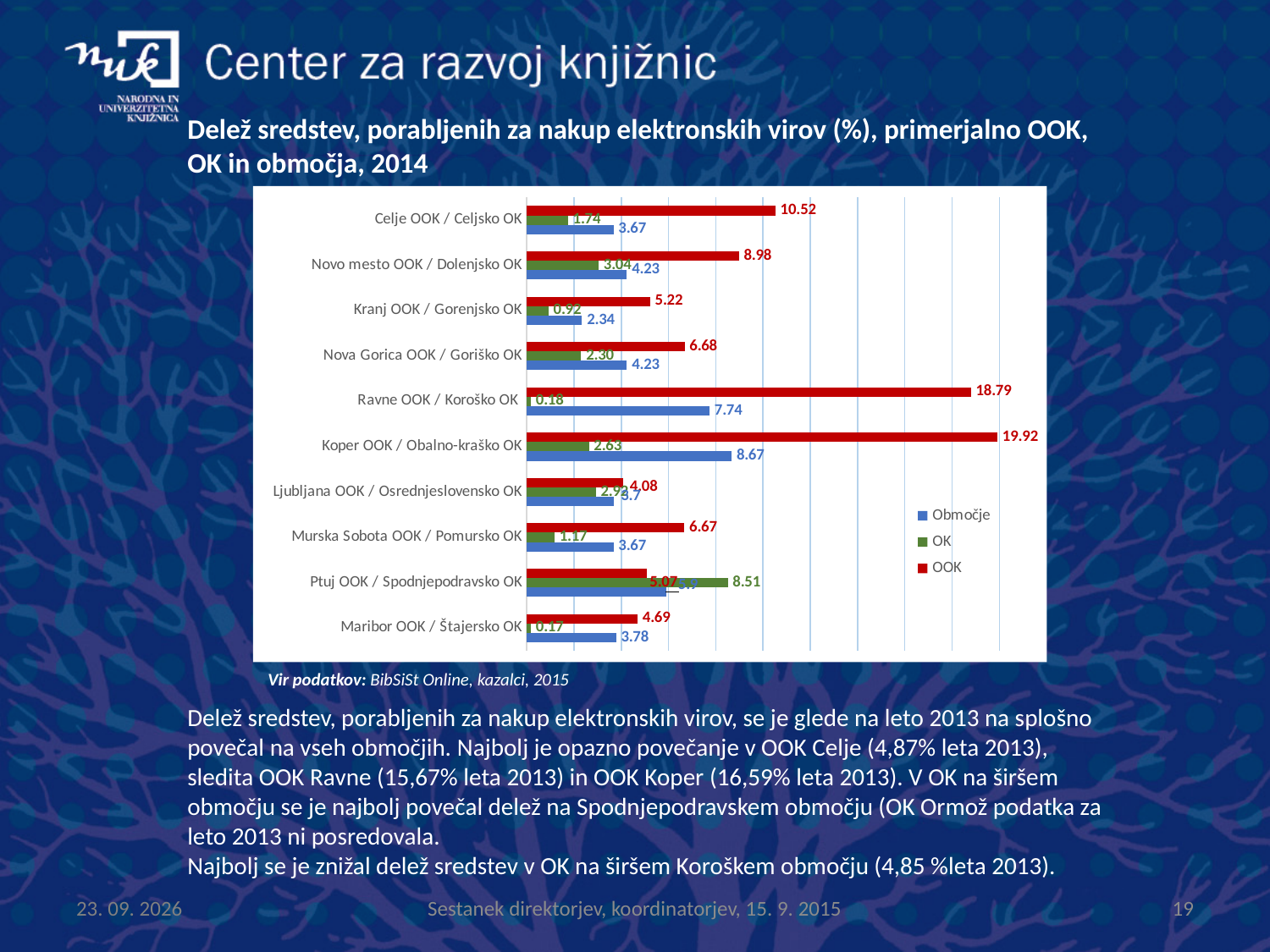
What is the OOK value for Koper OOK / Obalno-kraško OK? 19.92 What kind of chart is shown on the slide? bar chart Which has the larger OOK value, Celje OOK / Celjsko OK or Novo mesto OOK / Dolenjsko OK? Celje OOK / Celjsko OK What is the difference between the OOK values for Koper OOK / Obalno-kraško OK and Ravne OOK / Koroško OK? 1.13 Which category has the highest OK value? Ptuj OOK / Spodnjepodravsko OK How many series does the legend list? 3 How many categories (library pairs) are shown on the y axis? 10 Which category has the highest OOK value? Koper OOK / Obalno-kraško OK What is the Območje value for Ravne OOK / Koroško OK? 7.74 What is the OK value for Kranj OOK / Gorenjsko OK? 0.92 What is the Območje value for Maribor OOK / Štajersko OK? 3.78 What colour represents the OOK series in the legend? red